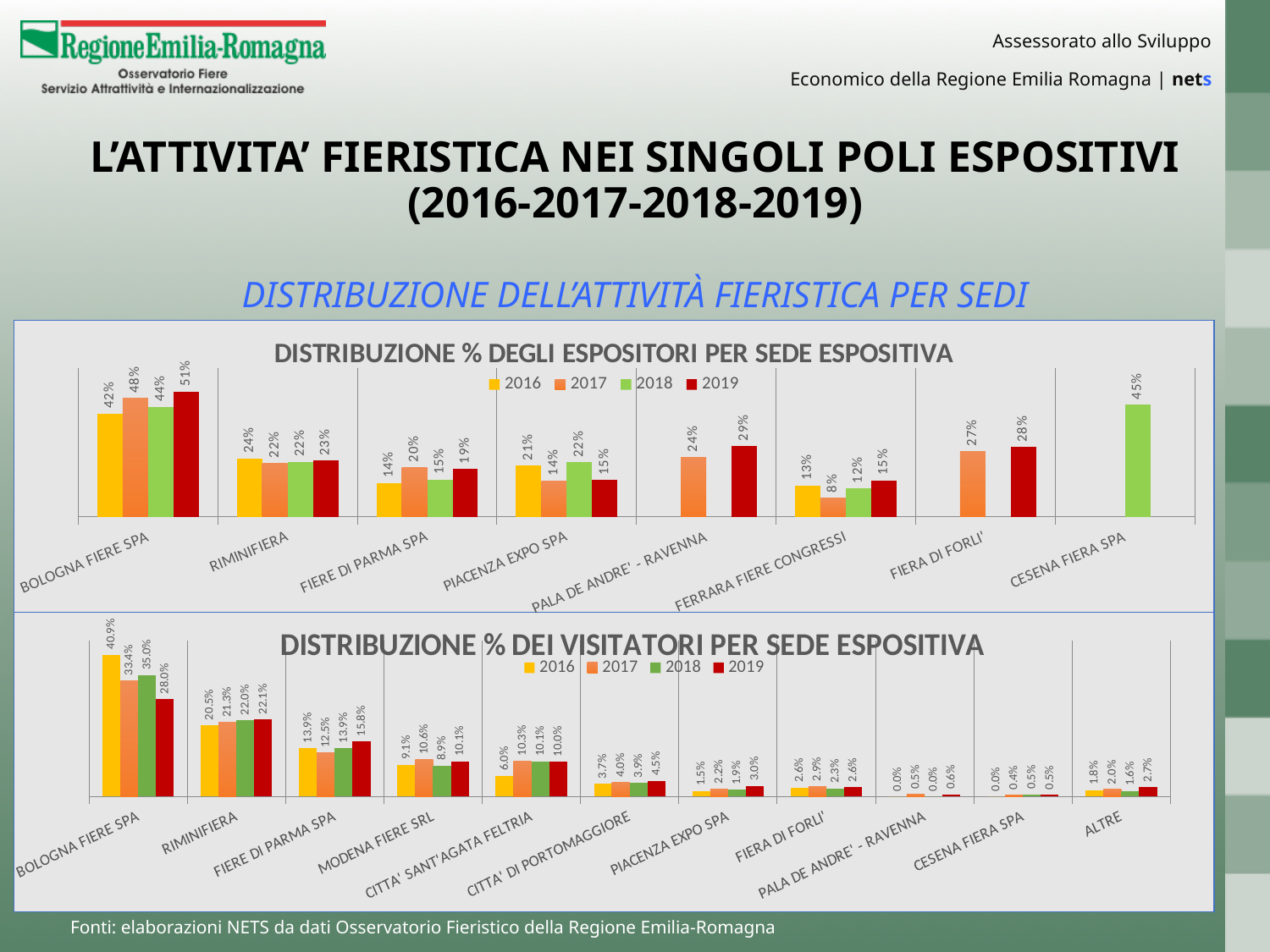
In the chart 'DISTRIBUZIONE % DEGLI ESPOSITORI PER SEDE ESPOSITIVA', what is the difference between the 2019 and 2016 values for BOLOGNA FIERE SPA? 9% In the chart 'DISTRIBUZIONE % DEGLI ESPOSITORI PER SEDE ESPOSITIVA', what is the value for BOLOGNA FIERE SPA in 2019? 51% How many sites are shown on the x axis of the chart 'DISTRIBUZIONE % DEI VISITATORI PER SEDE ESPOSITIVA'? 11 In the chart 'DISTRIBUZIONE % DEGLI ESPOSITORI PER SEDE ESPOSITIVA', what is the value for FIERE DI PARMA SPA in 2017? 20% How many series does the legend list in the chart 'DISTRIBUZIONE % DEGLI ESPOSITORI PER SEDE ESPOSITIVA'? 4 What kind of chart is 'DISTRIBUZIONE % DEI VISITATORI PER SEDE ESPOSITIVA'? bar chart In the chart 'DISTRIBUZIONE % DEGLI ESPOSITORI PER SEDE ESPOSITIVA', which site has the lowest value for 2017? FERRARA FIERE CONGRESSI In the chart 'DISTRIBUZIONE % DEI VISITATORI PER SEDE ESPOSITIVA', what is the value for MODENA FIERE SRL in 2018? 8.9% How many sites are shown on the x axis of the chart 'DISTRIBUZIONE % DEGLI ESPOSITORI PER SEDE ESPOSITIVA'? 8 In the chart 'DISTRIBUZIONE % DEI VISITATORI PER SEDE ESPOSITIVA', which is larger for 2019: RIMINIFIERA or FIERE DI PARMA SPA? RIMINIFIERA In the chart 'DISTRIBUZIONE % DEI VISITATORI PER SEDE ESPOSITIVA', do the values for BOLOGNA FIERE SPA rise or fall from 2016 to 2019 overall? fall In the chart 'DISTRIBUZIONE % DEI VISITATORI PER SEDE ESPOSITIVA', what is the value for BOLOGNA FIERE SPA in 2016? 40.9%